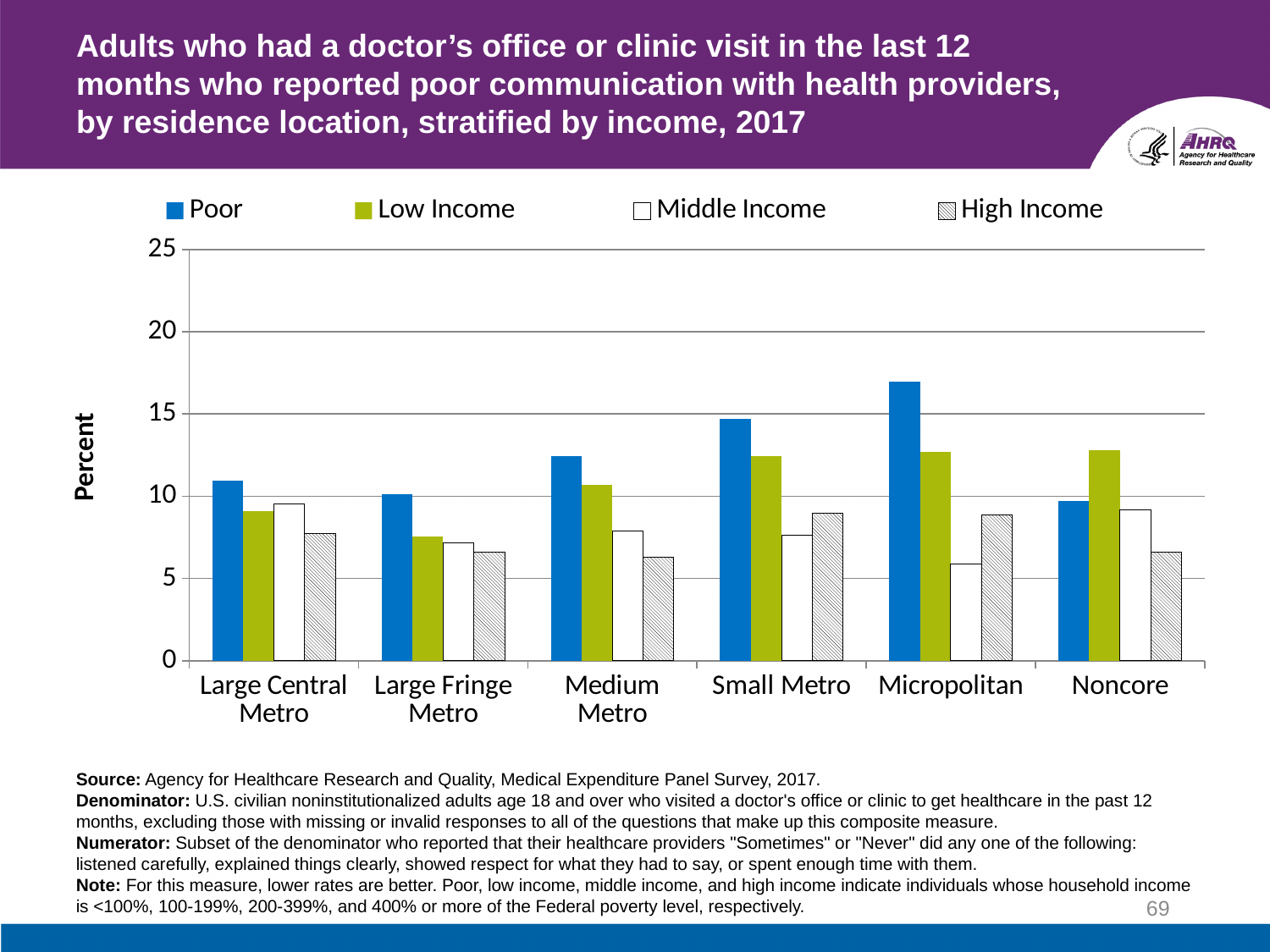
For Noncore, which is larger: the Poor value or the Low Income value? Low Income What kind of chart is shown on the slide? Bar chart How many income series does the legend list? 4 Which residence location has the lowest value for the Middle Income series? Micropolitan Is the Middle Income value for Micropolitan greater or less than 10? less For Small Metro, which is larger: the Middle Income value or the High Income value? High Income Is the Poor value for Micropolitan greater or less than 15? greater Is the High Income value for Large Fringe Metro greater or less than 10? less How many residence location categories are shown on the x axis? 6 What is the label on the vertical axis of the chart? Percent Which residence location has the highest value for the Poor series? Micropolitan